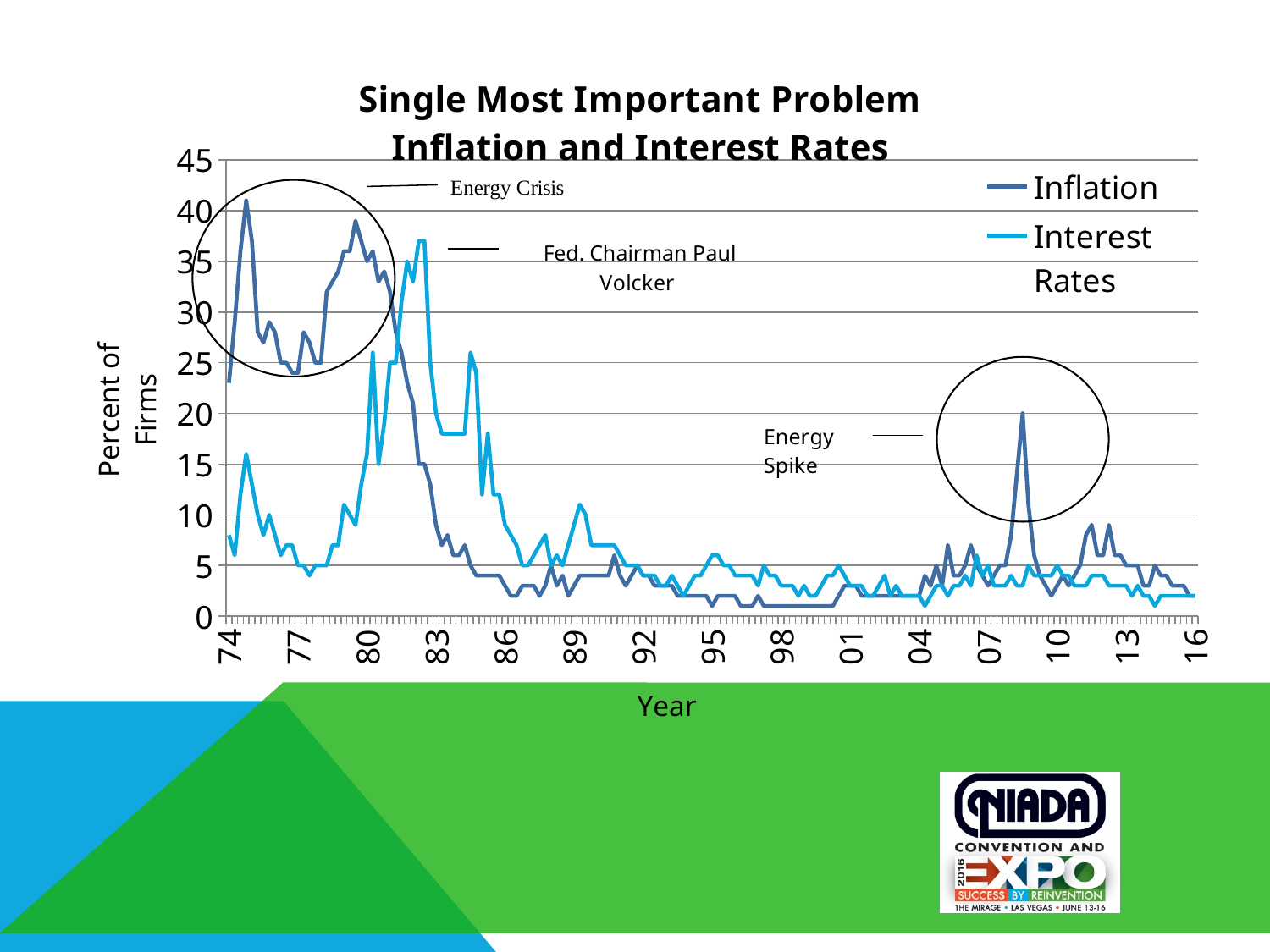
Does the Inflation series generally rise or fall between 1980 and 1990? fall What is the title of the chart? Single Most Important Problem Inflation and Interest Rates Is the peak value of the Inflation series in the mid-1970s greater or less than 35? greater Is the Inflation value at the 2008 'Energy Spike' peak greater or less than 15? greater Is the Interest Rates value in 2016 greater or less than 5? less How many series does the legend list? 2 Around 1982, which series is higher, Inflation or Interest Rates? Interest Rates What kind of chart is shown on the slide? Line chart Around 1975, which series is higher, Inflation or Interest Rates? Inflation What is the label on the vertical axis? Percent of Firms Which series has the higher peak value over the whole period, Inflation or Interest Rates? Inflation